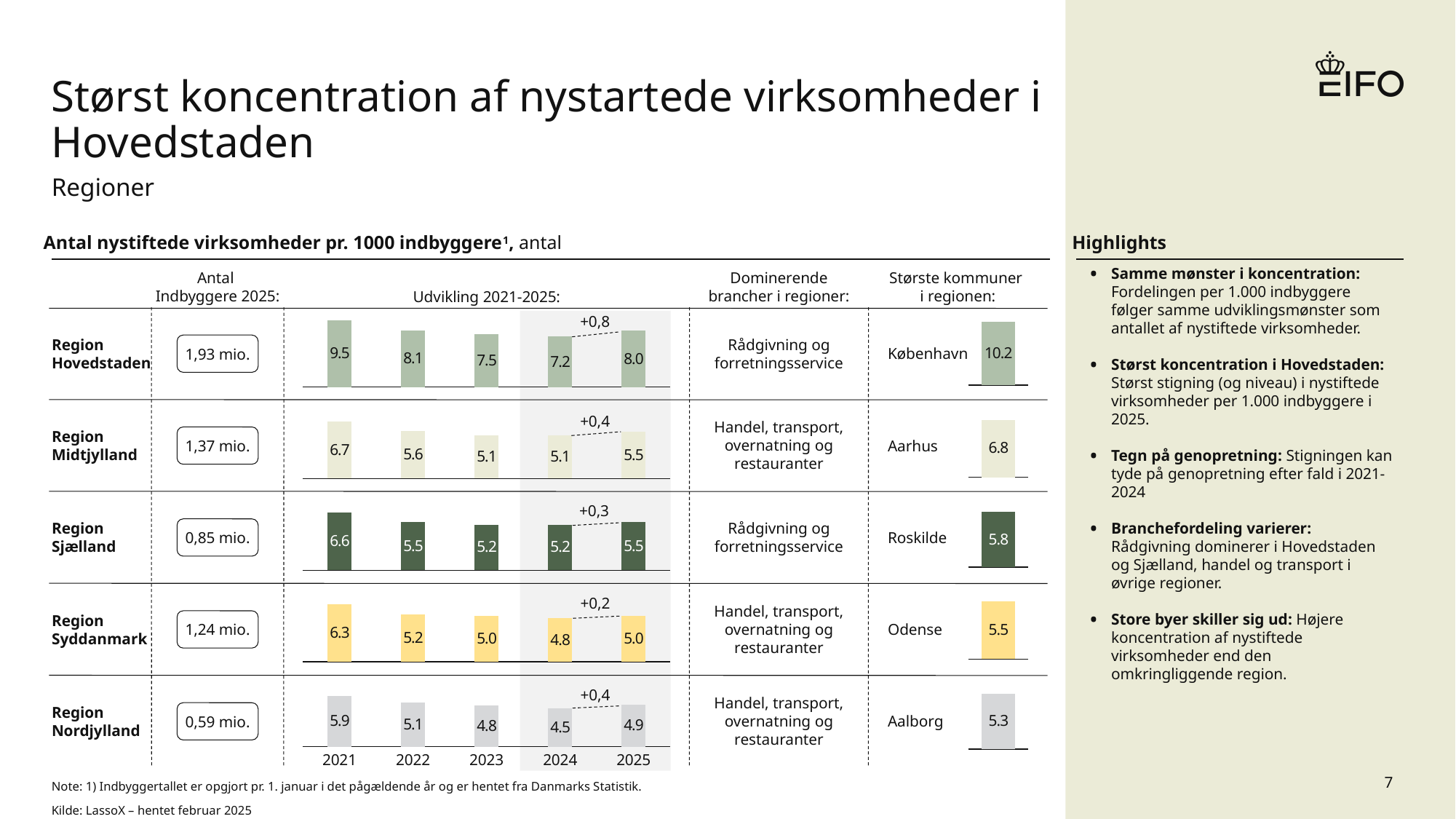
In the Region Midtjylland chart, which year has the highest value? 2021 In the Største kommuner i regionen column, what is the value shown for København? 10.2 In the Region Hovedstaden chart, what is the change from 2024 to 2025 shown above the bars? +0,8 How many years are plotted in each region's Udvikling 2021-2025 chart? 5 In the Region Nordjylland chart, what is the value for 2024? 4.5 Which is larger: the 2025 value for Region Hovedstaden or the 2025 value for Region Midtjylland? Region Hovedstaden In the Region Syddanmark chart, which year has the lowest value? 2024 What kind of chart is used to show the Udvikling 2021-2025 for each region? Bar chart In the Region Sjælland chart, what is the difference between the 2021 value and the 2023 value? 1.4 In the Region Hovedstaden chart, what is the value for 2021? 9.5 In the Region Nordjylland chart, do the values rise or fall from 2021 to 2024? Fall What is the title of the chart section on the slide? Antal nystiftede virksomheder pr. 1000 indbyggere, antal